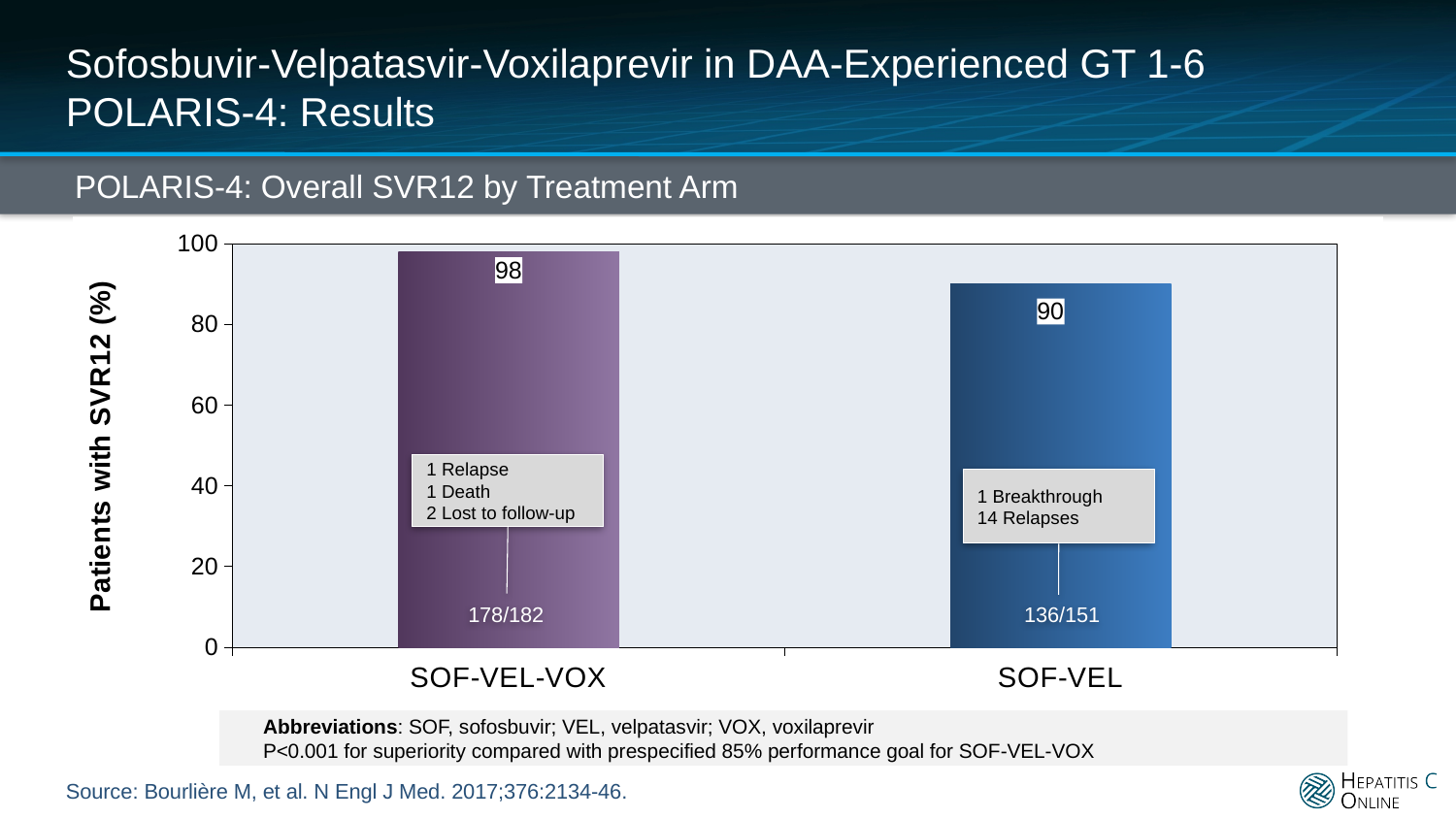
What is the SVR12 rate for the SOF-VEL arm? 90 What fraction of patients achieved SVR12 in the SOF-VEL arm? 136/151 Which arm has a larger SVR12 rate, SOF-VEL-VOX or SOF-VEL? SOF-VEL-VOX Which treatment arm has the lowest SVR12 rate? SOF-VEL What is the title of the chart? POLARIS-4: Overall SVR12 by Treatment Arm What is the difference in SVR12 rate between SOF-VEL-VOX and SOF-VEL? 8 Is the value for SOF-VEL greater or less than 80? greater Which treatment arm has the highest SVR12 rate? SOF-VEL-VOX What kind of chart is shown on the slide? Bar chart How many treatment arms are shown in the chart? 2 What is the SVR12 rate for the SOF-VEL-VOX arm? 98 What fraction of patients achieved SVR12 in the SOF-VEL-VOX arm? 178/182